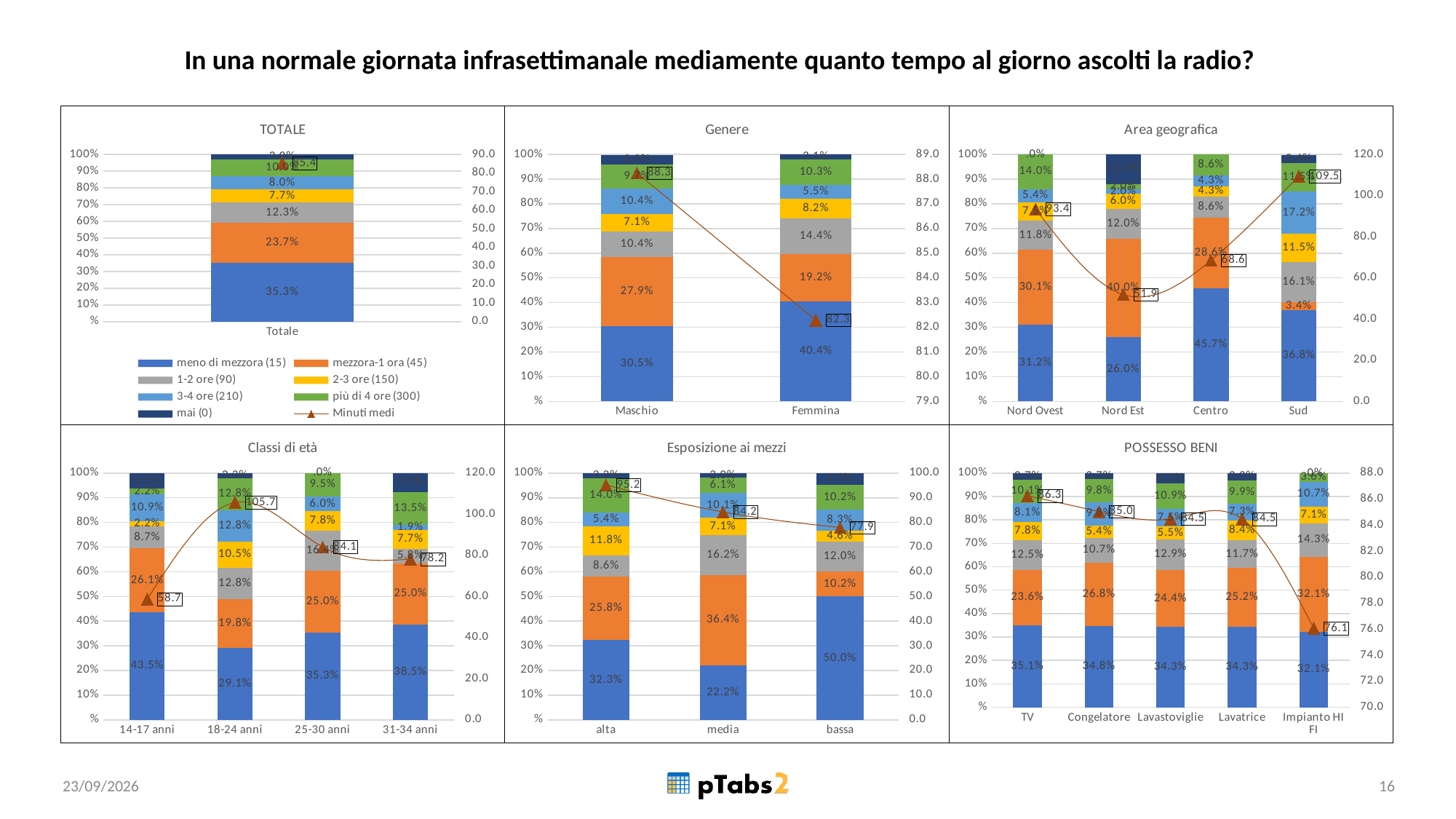
In the Area geografica chart, which area has the highest 'Minuti medi' value? Sud In the Area geografica chart, which area has the lowest 'Minuti medi' value? Nord Est In the Genere chart, what percentage of Maschio is in the 'mezzora-1 ora (45)' segment? 27.9% In the Classi di età chart, what is the difference between the 'meno di mezzora (15)' percentages for 14-17 anni and 18-24 anni? 14.4% In the Esposizione ai mezzi chart, which category has the larger 'meno di mezzora (15)' share, alta or bassa? bassa In the Esposizione ai mezzi chart, what percentage of 'media' is in the 'mezzora-1 ora (45)' segment? 36.4% How many series does the legend in the TOTALE chart list? 8 In the POSSESSO BENI chart, how many categories are shown on the x axis? 5 In the POSSESSO BENI chart, what is the 'Minuti medi' value for Impianto HI FI? 76.1 In the Classi di età chart, what is the 'Minuti medi' value for 18-24 anni? 105.7 In the Genere chart, what is the 'Minuti medi' value for Femmina? 82.3 In the TOTALE chart, what percentage is shown for 'meno di mezzora (15)'? 35.3%